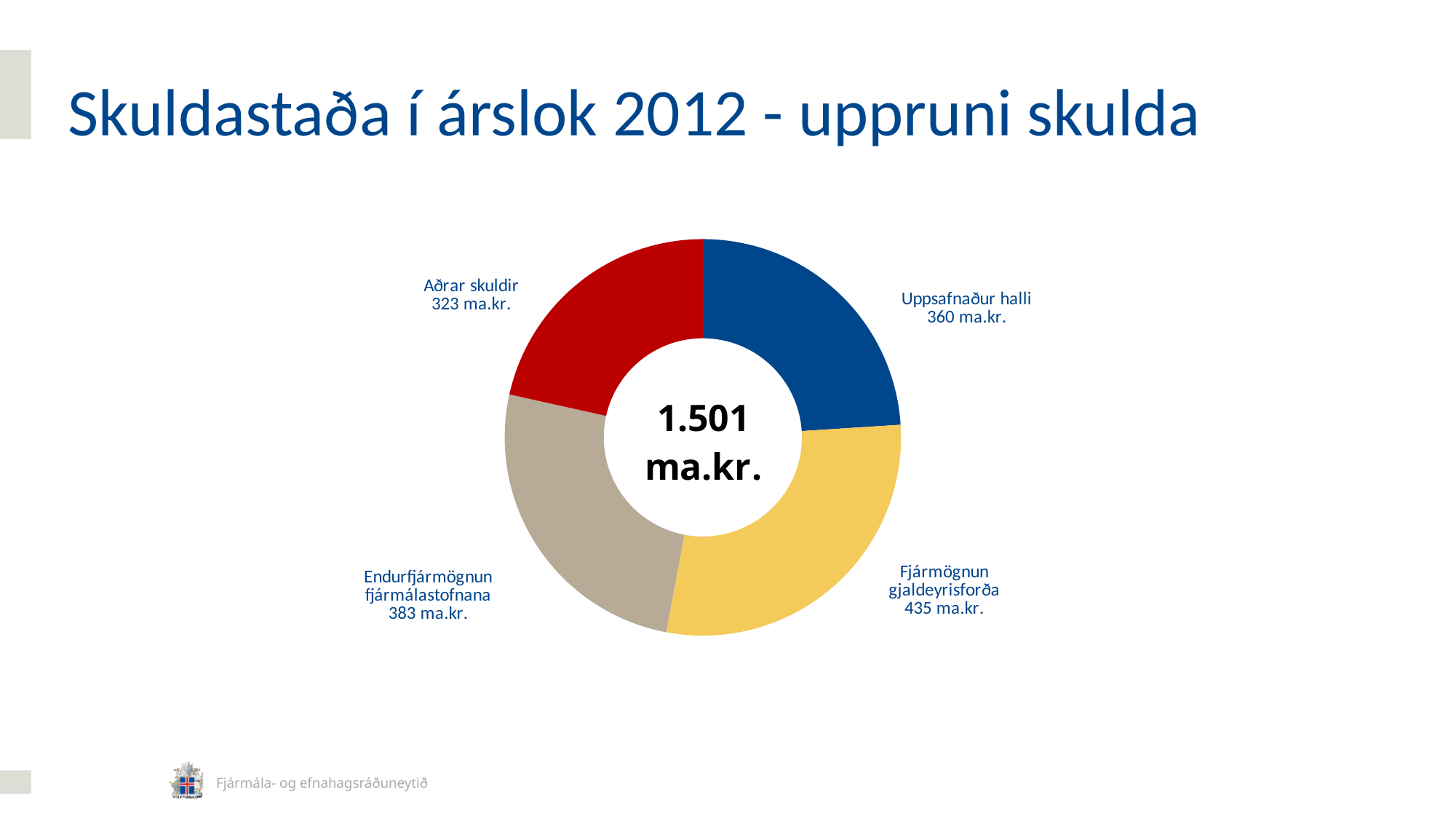
What total is shown in the centre of the chart? 1.501 ma.kr. How many categories does the chart show? 4 What is the value for Aðrar skuldir? 323 ma.kr. Which category has the largest value? Fjármögnun gjaldeyrisforða What is the value for Fjármögnun gjaldeyrisforða? 435 ma.kr. What is the difference between Endurfjármögnun fjármálastofnana and Aðrar skuldir? 60 ma.kr. Which is larger, Endurfjármögnun fjármálastofnana or Uppsafnaður halli? Endurfjármögnun fjármálastofnana What is the difference between Fjármögnun gjaldeyrisforða and Uppsafnaður halli? 75 ma.kr. Which category has the smallest value? Aðrar skuldir What kind of chart is shown on the slide? doughnut chart What is the value for Endurfjármögnun fjármálastofnana? 383 ma.kr. What is the value for Uppsafnaður halli? 360 ma.kr.